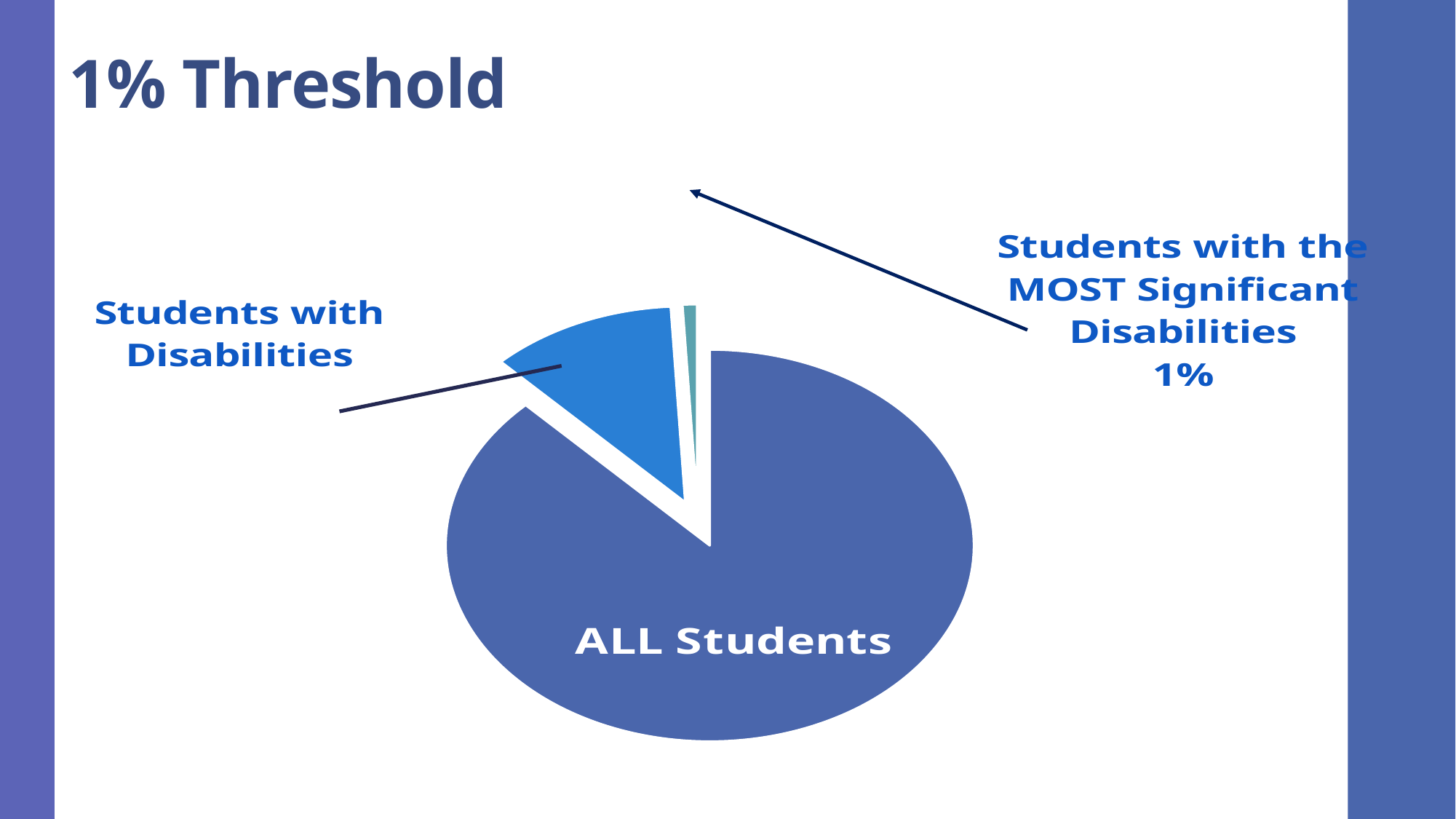
Which slice of the pie chart is labelled directly inside the slice? ALL Students What kind of chart is shown on the slide? pie chart What is the title of the slide containing the pie chart? 1% Threshold Which slice of the pie chart is the largest? ALL Students What share of the pie is labelled for Students with the MOST Significant Disabilities? 1% Which slice is larger: Students with Disabilities or Students with the MOST Significant Disabilities? Students with Disabilities Which slice of the pie chart is the smallest? Students with the MOST Significant Disabilities How many slices does the pie chart have? 3 Which slice is larger: ALL Students or Students with Disabilities? ALL Students